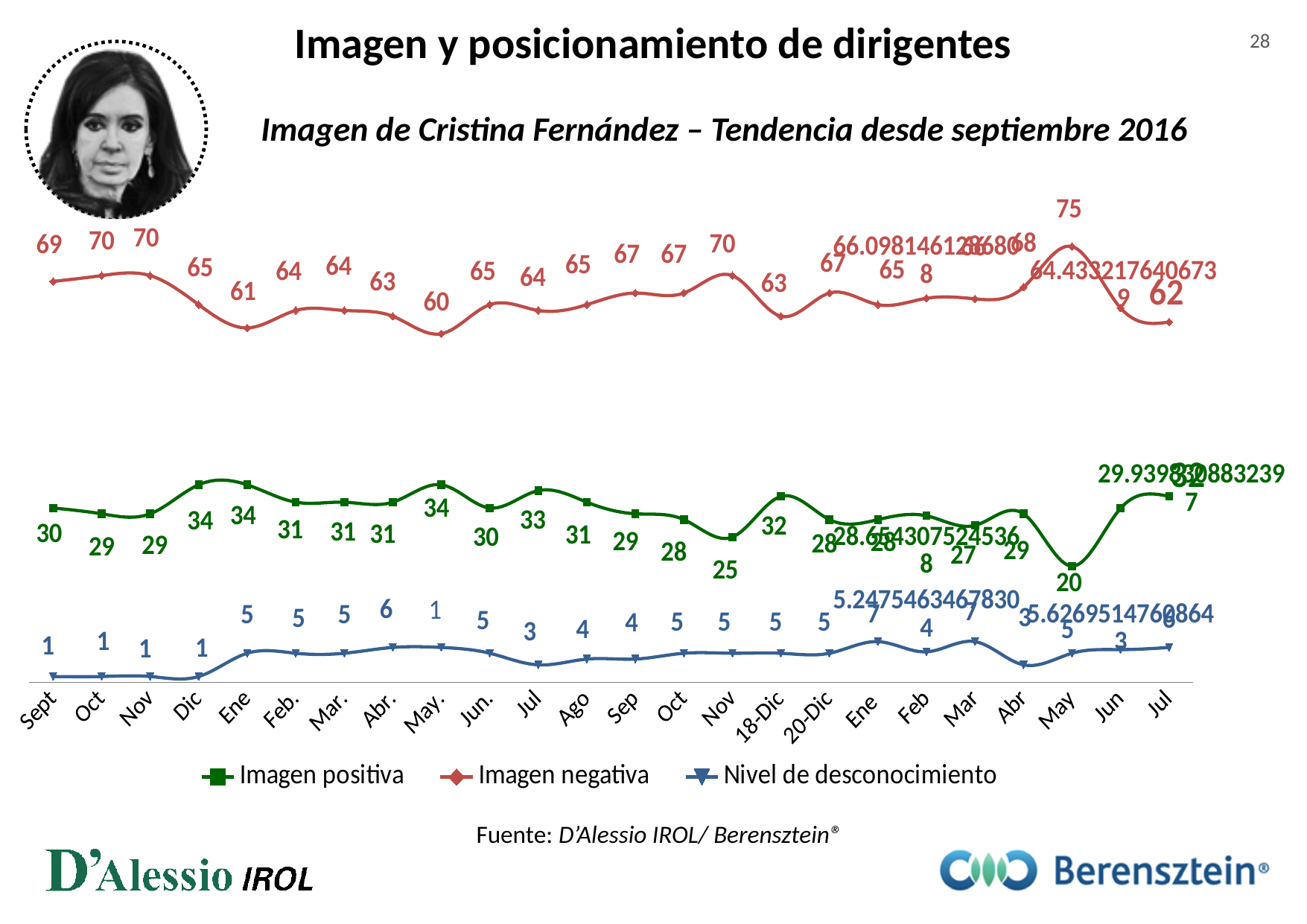
What is the value of Imagen negativa in Sept (the first point)? 69 What is the value of Imagen positiva at the second Nov point? 25 Which series has the higher value in Ene (the first Ene): Imagen positiva or Imagen negativa? Imagen negativa What is the highest value shown for Imagen negativa? 75 What is the difference between Imagen negativa and Imagen positiva in Dic (the first Dic)? 31 What is the value of Nivel de desconocimiento in Abr. (the first year)? 6 What is the lowest value shown for Imagen positiva? 20 What is the value of Imagen negativa at the last point (Jul)? 62 Which series is drawn in red? Imagen negativa How many series does the legend list? 3 What type of chart is shown on the slide? line chart What is the value of Imagen positiva in Sept (the first point)? 30